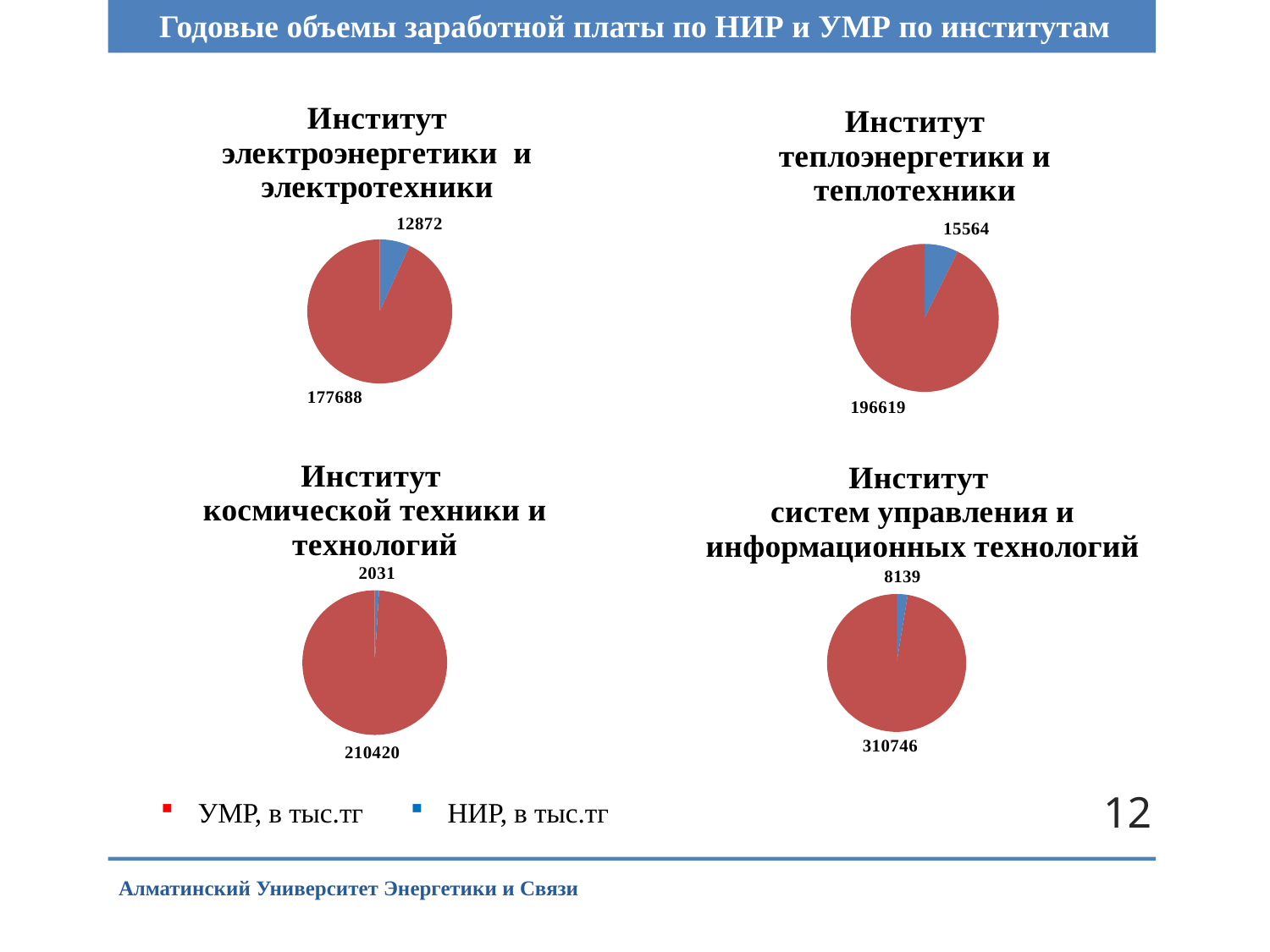
In the pie chart for Институт теплоэнергетики и теплотехники, what is the total of the two slices? 212183 What type of chart is used for each institute on this slide? Pie chart Across the four pie charts, which institute has the largest УМР value? Институт систем управления и информационных технологий In the pie chart for Институт электроэнергетики и электротехники, what is the difference between the УМР and НИР values? 164816 In the pie chart for Институт электроэнергетики и электротехники, what is the value for НИР? 12872 In the pie chart for Институт космической техники и технологий, what is the value for НИР? 2031 Across the four pie charts, which institute has the smallest НИР value? Институт космической техники и технологий In the pie chart for Институт систем управления и информационных технологий, which is larger, УМР or НИР? УМР In the pie chart for Институт систем управления и информационных технологий, what is the value for УМР? 310746 According to the legend, which colour represents НИР, в тыс.тг? Blue In the pie chart for Институт теплоэнергетики и теплотехники, what is the value for УМР? 196619 How many series does the legend at the bottom of the slide list? 2